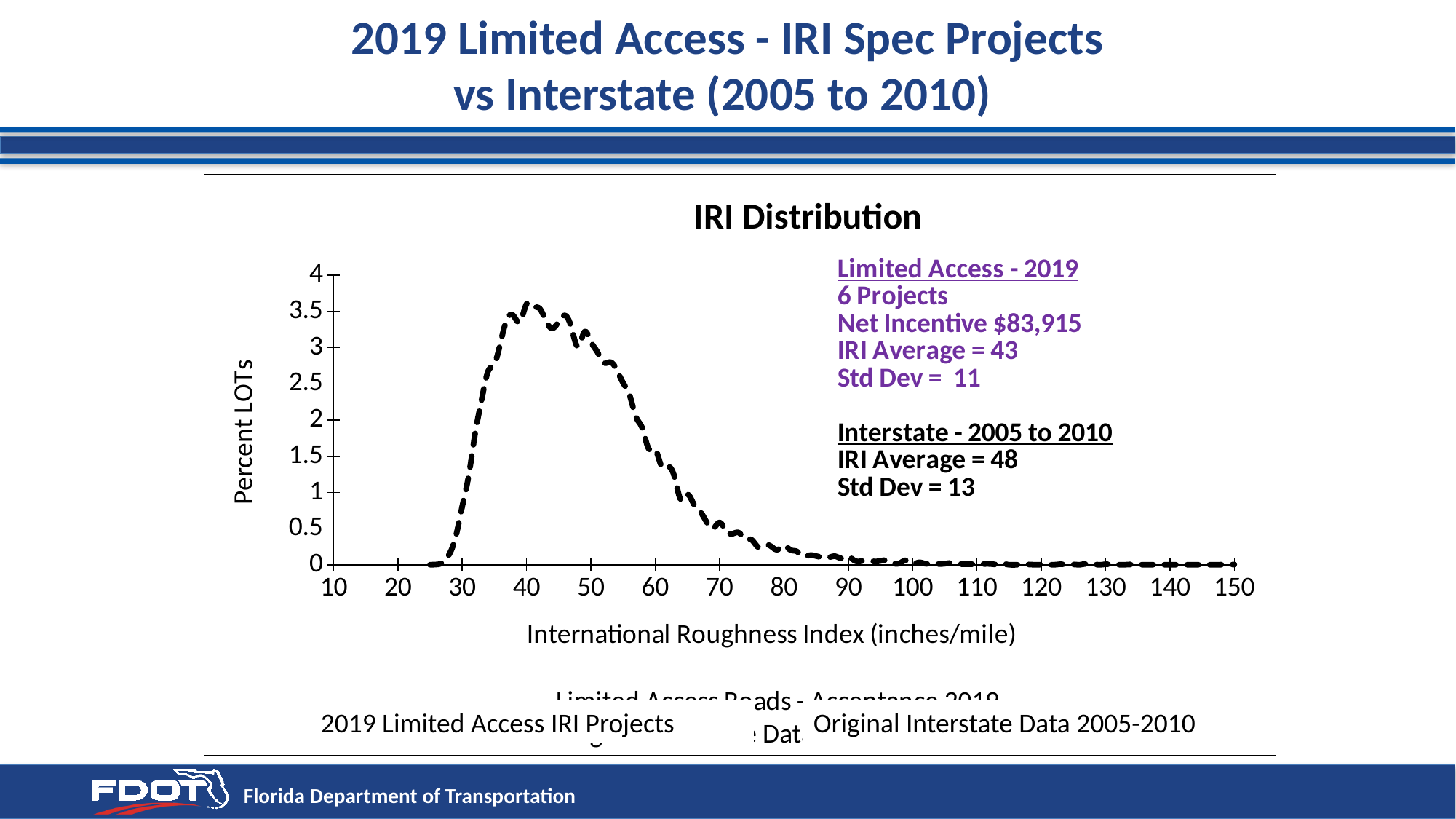
Is the value of the plotted line at an IRI of 20 greater or less than 0.5? less According to the annotation on the chart, what is the IRI Average for Limited Access - 2019? 43 What is the label of the x axis of the chart? International Roughness Index (inches/mile) Is the value of the plotted line at an IRI of 100 greater or less than 0.5? less Does the plotted line rise or fall as the IRI increases from 50 to 80? fall Is the value of the plotted line at an IRI of 40 greater or less than 3? greater Does the plotted line rise or fall as the IRI increases from 28 to 38? rise What kind of chart is shown on the slide? line chart According to the annotation on the chart, what is the Std Dev for Interstate - 2005 to 2010? 13 What is the title of the chart? IRI Distribution